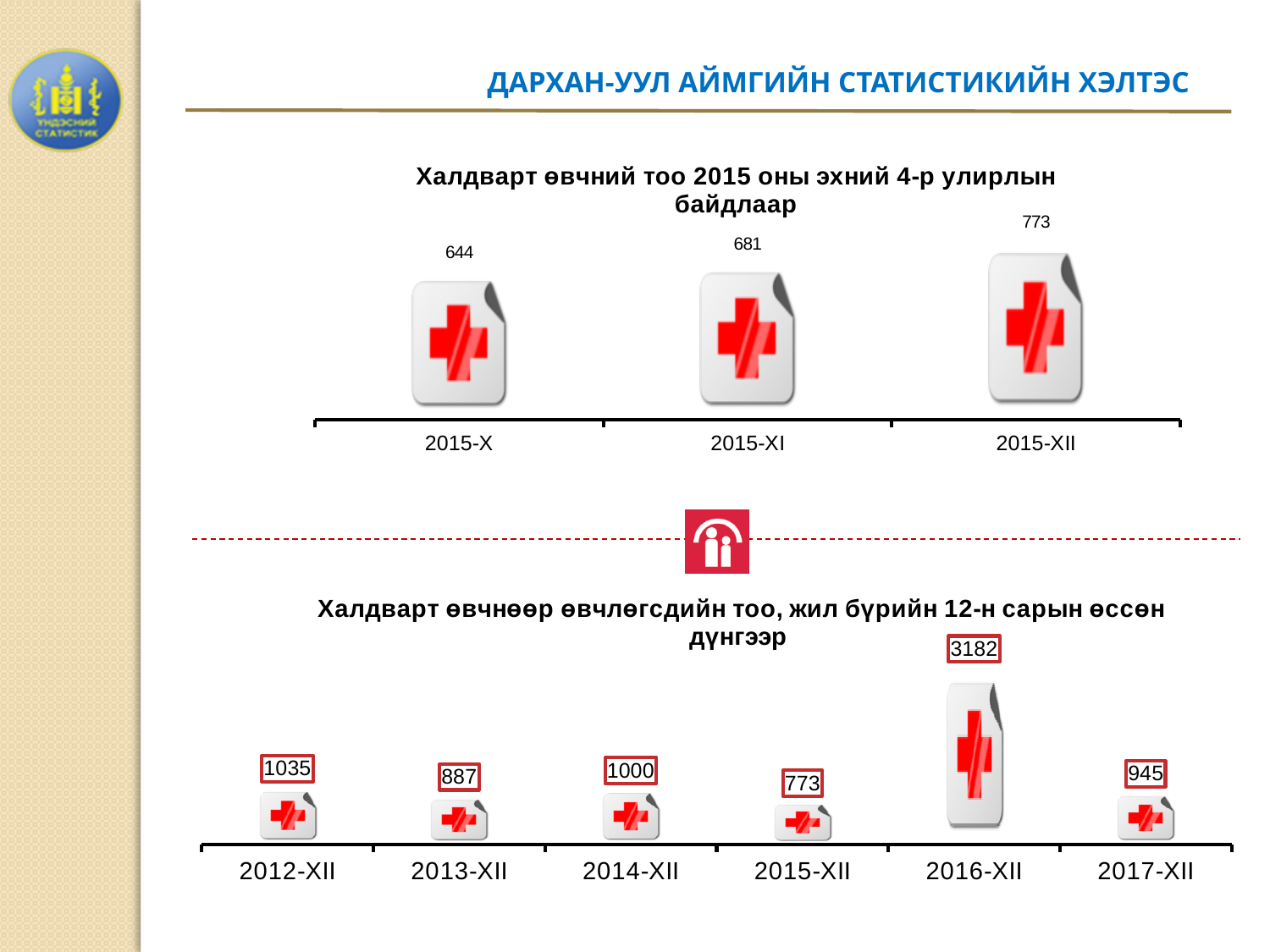
What is the title of the top chart? Халдварт өвчний тоо 2015 оны эхний 4-р улирлын байдлаар In the top chart, what is the value for 2015-XI? 681 In the top chart, what is the difference between the values for 2015-XII and 2015-X? 129 In the top chart, how many categories are shown on the x axis? 3 In the bottom chart, which year has the lowest value? 2015-XII In the bottom chart, what is the difference between the values for 2016-XII and 2017-XII? 2237 In the bottom chart, how many categories are shown on the x axis? 6 In the top chart, do the values rise or fall from 2015-X to 2015-XII? rise In the bottom chart, what is the value for 2016-XII? 3182 What kind of chart is the bottom chart? bar chart In the top chart, which month has the highest value? 2015-XII In the bottom chart, which is larger, the value for 2012-XII or the value for 2013-XII? 2012-XII